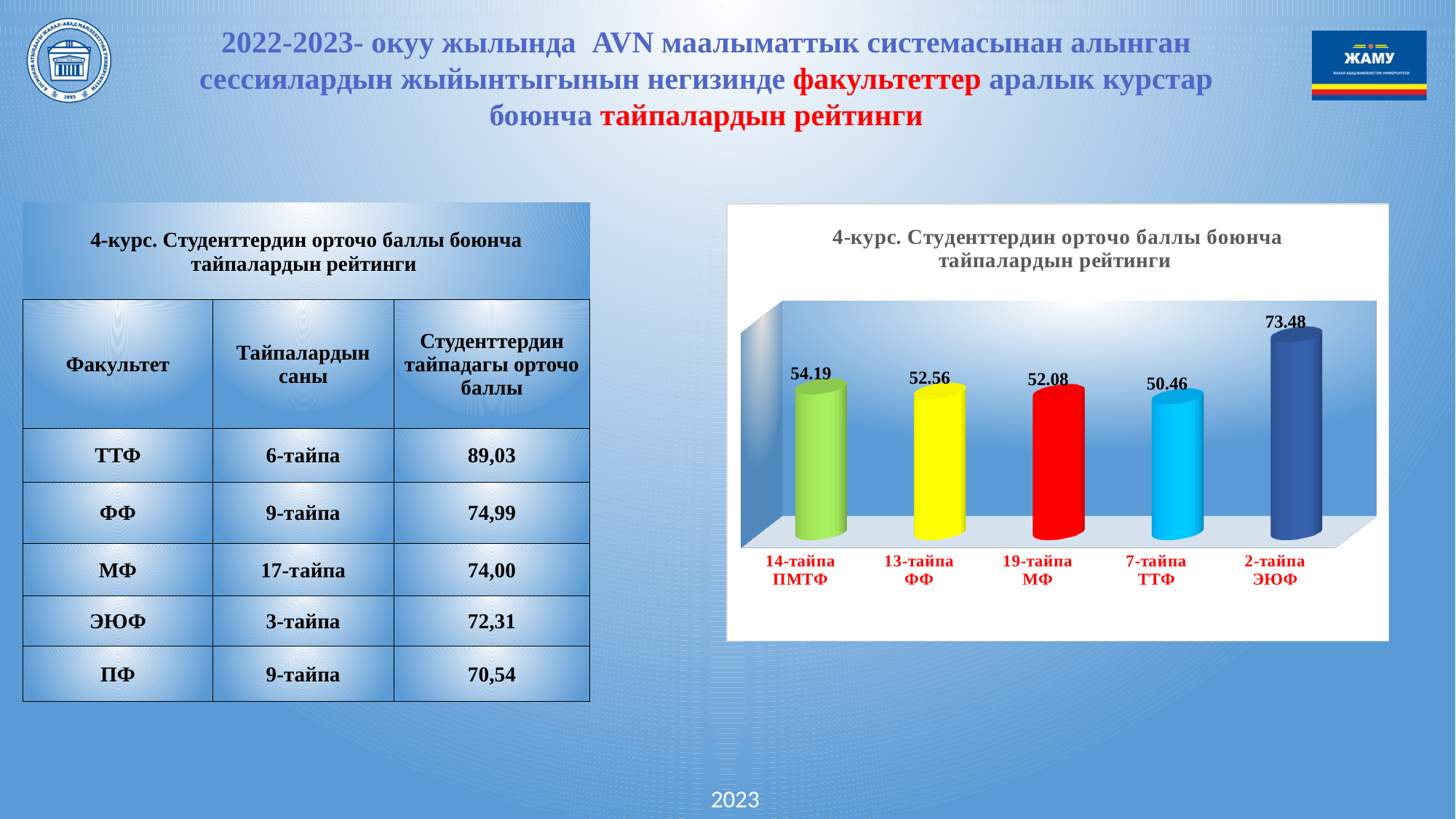
Which category has the highest value in the chart? 2-тайпа ЭЮФ What is the value for 7-тайпа ТТФ in the chart? 50.46 What is the value for 19-тайпа МФ in the chart? 52.08 What is the value for 13-тайпа ФФ in the chart? 52.56 What is the title of the chart? 4-курс. Студенттердин орточо баллы боюнча тайпалардын рейтинги What is the difference between the values for 2-тайпа ЭЮФ and 7-тайпа ТТФ? 23.02 Which is larger, the value for 14-тайпа ПМТФ or the value for 13-тайпа ФФ? 14-тайпа ПМТФ What is the value for 14-тайпа ПМТФ in the chart? 54.19 What type of chart is shown on the slide? bar chart How many categories are shown in the chart? 5 What is the value for 2-тайпа ЭЮФ in the chart? 73.48 Which category has the lowest value in the chart? 7-тайпа ТТФ